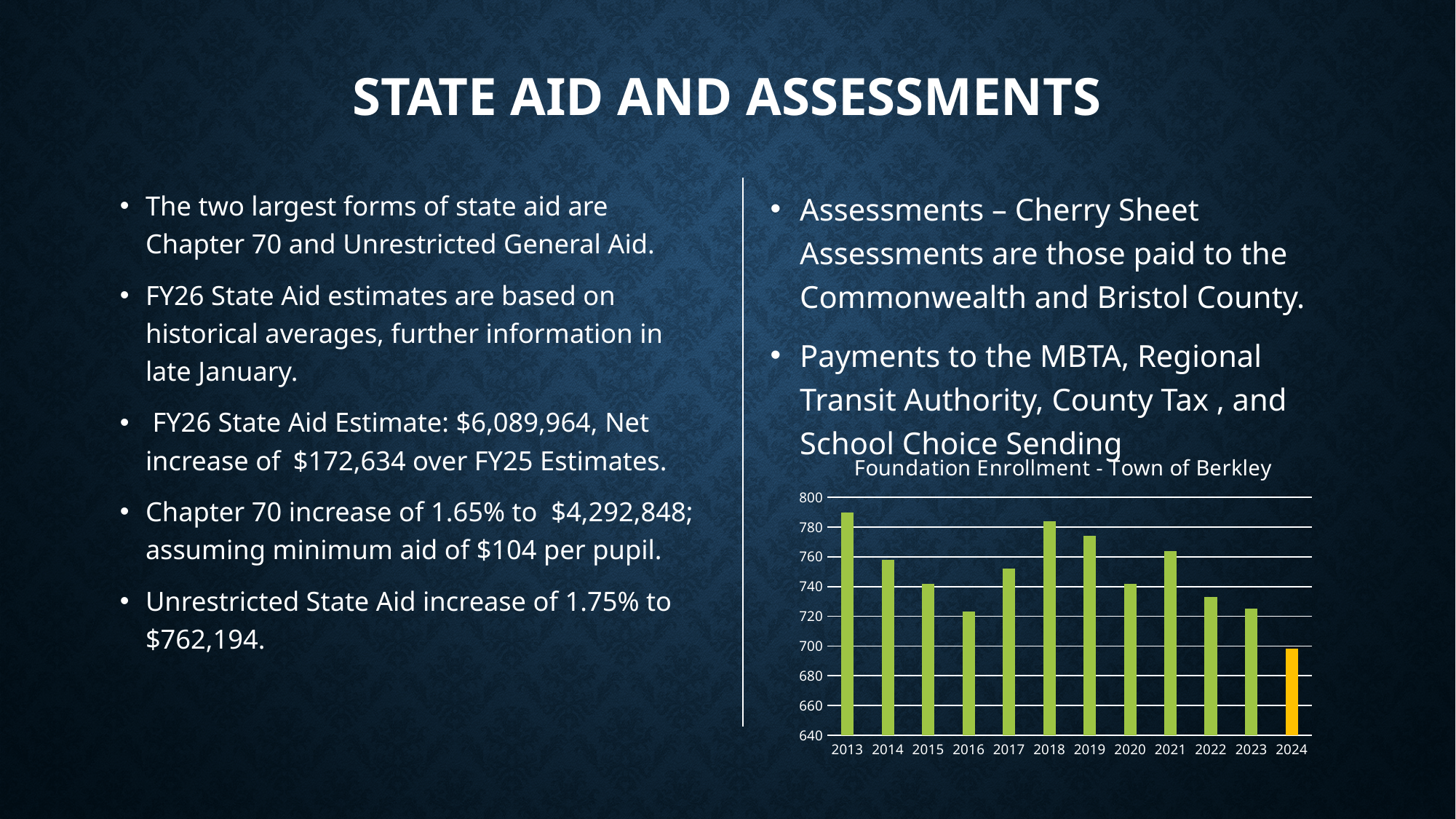
How many years are plotted in the Foundation Enrollment chart? 12 Is the foundation enrollment value for 2013 greater or less than 780? greater Which year has the lowest foundation enrollment in the chart? 2024 What is the title of the chart on the slide? Foundation Enrollment - Town of Berkley What kind of chart is shown on the slide? bar chart Which bar in the Foundation Enrollment chart is coloured differently from the others? 2024 Which year has the larger foundation enrollment, 2021 or 2023? 2021 Is the foundation enrollment value for 2017 greater or less than 760? less Which year has the larger foundation enrollment, 2018 or 2016? 2018 Is the foundation enrollment value for 2022 greater or less than 740? less